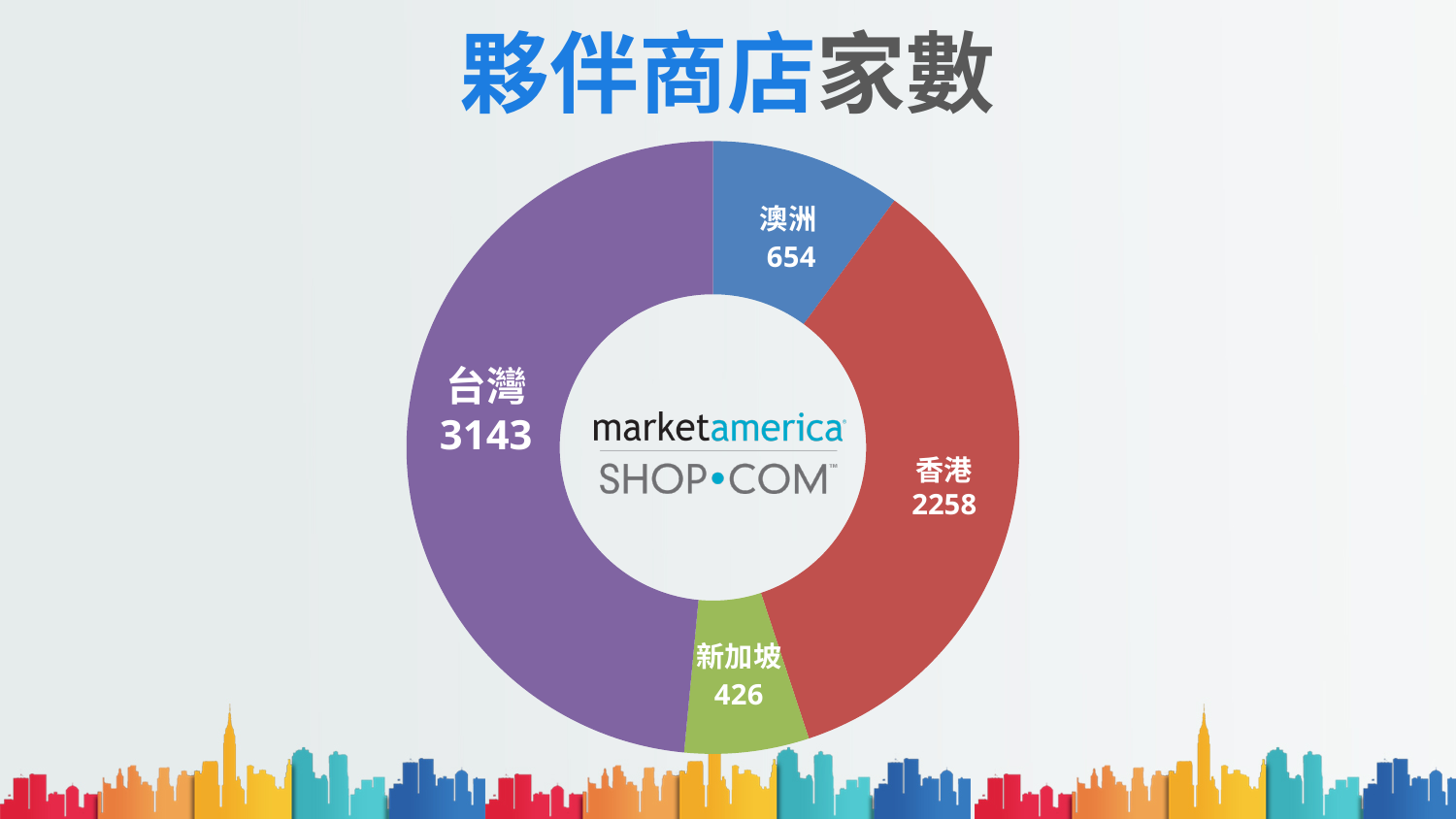
What is the value for 香港? 2258 What is the value for 台灣? 3143 What is the difference between the values for 台灣 and 香港? 885 What is the value for 新加坡? 426 Which category has the lowest value? 新加坡 How many categories does the chart show? 4 What is the value for 澳洲? 654 What kind of chart is shown on the slide? Pie chart (donut) What is the title of the chart? 夥伴商店家數 What is the total of all four categories in the chart? 6481 Which is larger, the value for 澳洲 or the value for 新加坡? 澳洲 Which category has the highest value? 台灣